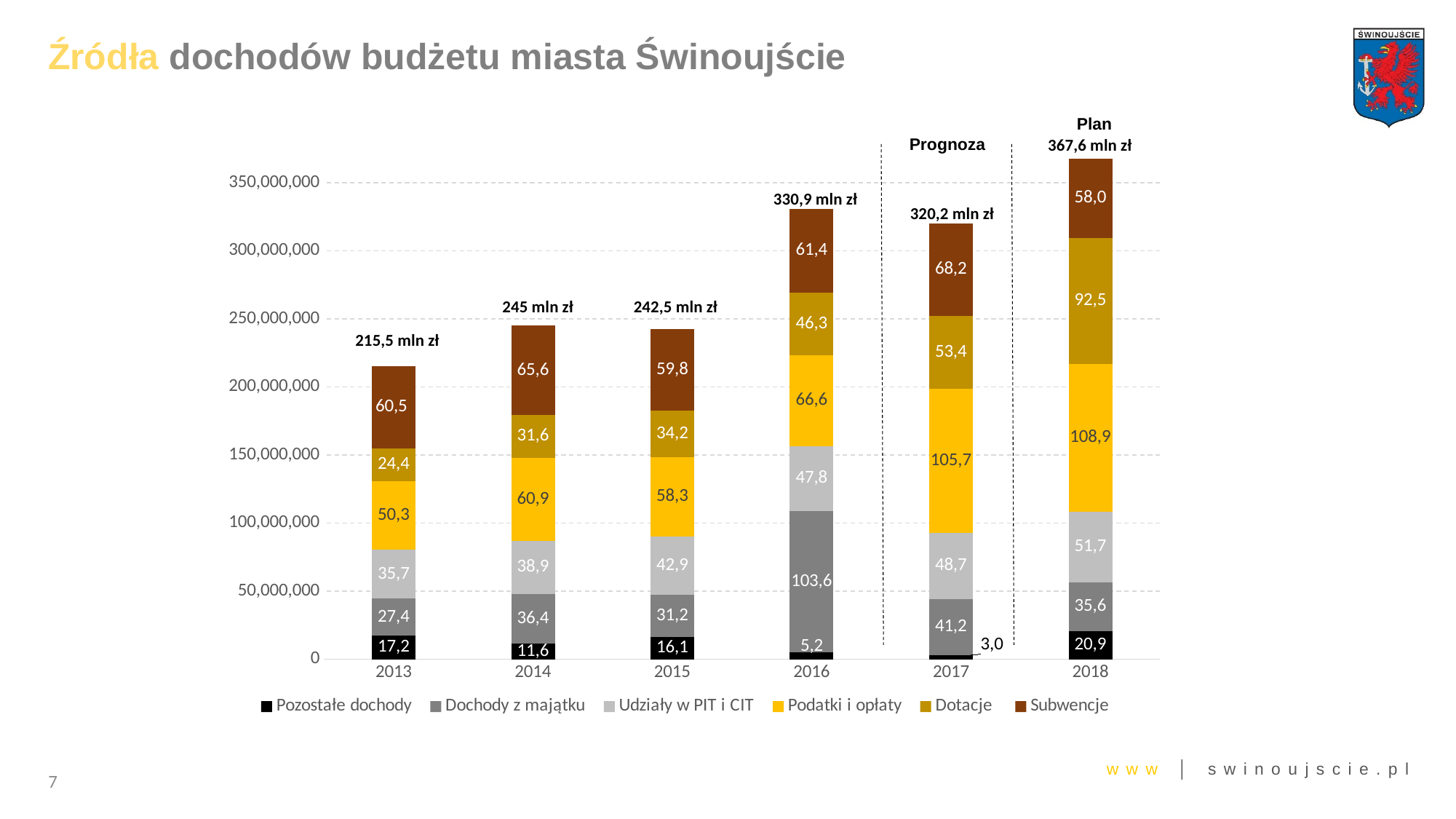
Which year has the highest total income? 2018 Which year has the lowest total income? 2013 What is the value of Dochody z majątku for 2016? 103,6 What is the difference between Dotacje in 2018 and Dotacje in 2017? 39,1 What is the value of Pozostałe dochody for 2017? 3,0 What is the total income shown for 2016? 330,9 mln zł How many years are shown on the x axis? 6 What is the value of Subwencje for 2013? 60,5 How many series does the legend list? 6 Which is larger: Dochody z majątku in 2016 or in 2015? 2016 What kind of chart is shown on the slide? Stacked bar chart What is the value of Podatki i opłaty for 2017? 105,7